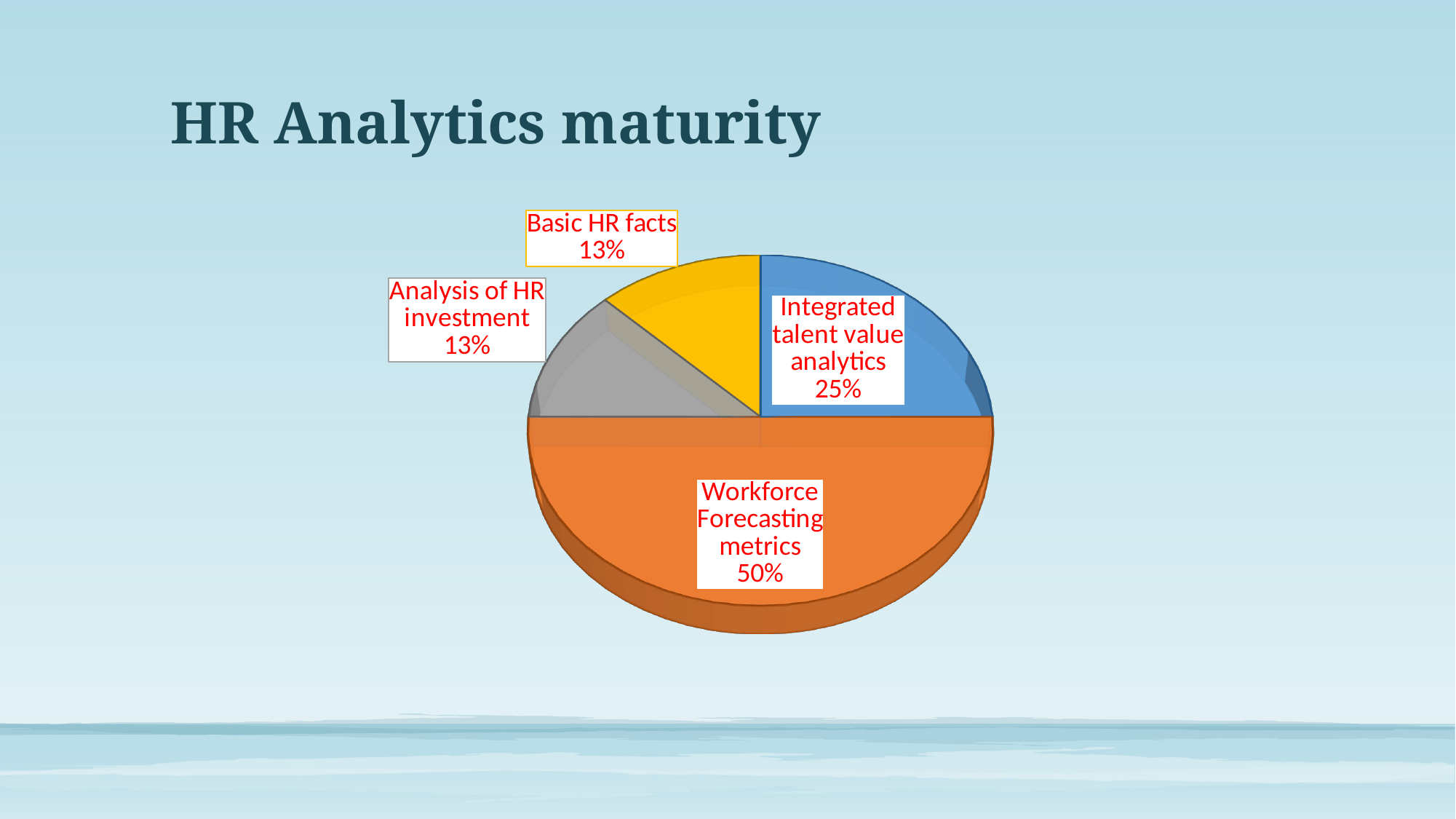
What percentage is shown for Analysis of HR investment? 13% What is the title of the slide containing the pie chart? HR Analytics maturity What is the difference in percentage points between Workforce Forecasting metrics and Integrated talent value analytics? 25 What colour is the Workforce Forecasting metrics slice? orange What kind of chart is shown on the slide? pie chart What percentage is shown for Integrated talent value analytics? 25% How many slices does the pie chart have? 4 What is the combined percentage of Basic HR facts and Analysis of HR investment? 26% Which slice of the pie chart is the largest? Workforce Forecasting metrics What percentage is shown for Basic HR facts? 13% Which is larger: Integrated talent value analytics or Basic HR facts? Integrated talent value analytics What percentage is shown for Workforce Forecasting metrics? 50%